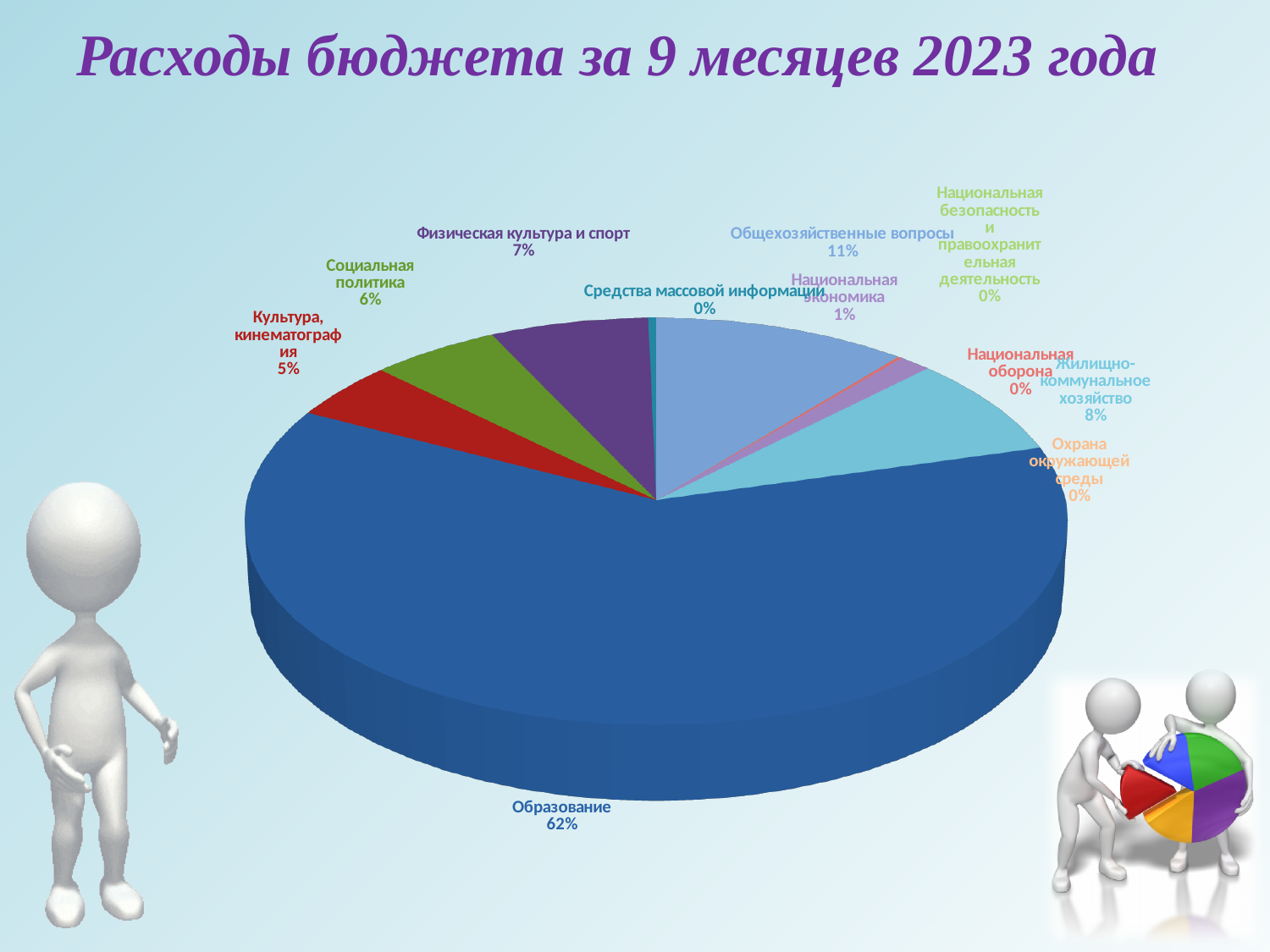
Which is larger: the share for Культура, кинематография or the share for Социальная политика? Социальная политика What percentage is shown for Жилищно-коммунальное хозяйство? 8% What percentage is shown for Общехозяйственные вопросы? 11% What percentage is shown for Социальная политика? 6% What is the title of the chart on the slide? Расходы бюджета за 9 месяцев 2023 года Which category has the largest share of the pie? Образование How many categories are labelled on the pie chart? 11 What percentage is shown for Физическая культура и спорт? 7% What is the difference in percentage points between Образование and Общехозяйственные вопросы? 51 What share of the budget expenses goes to Образование? 62% What percentage is shown for Национальная экономика? 1% What kind of chart is shown on the slide? pie chart